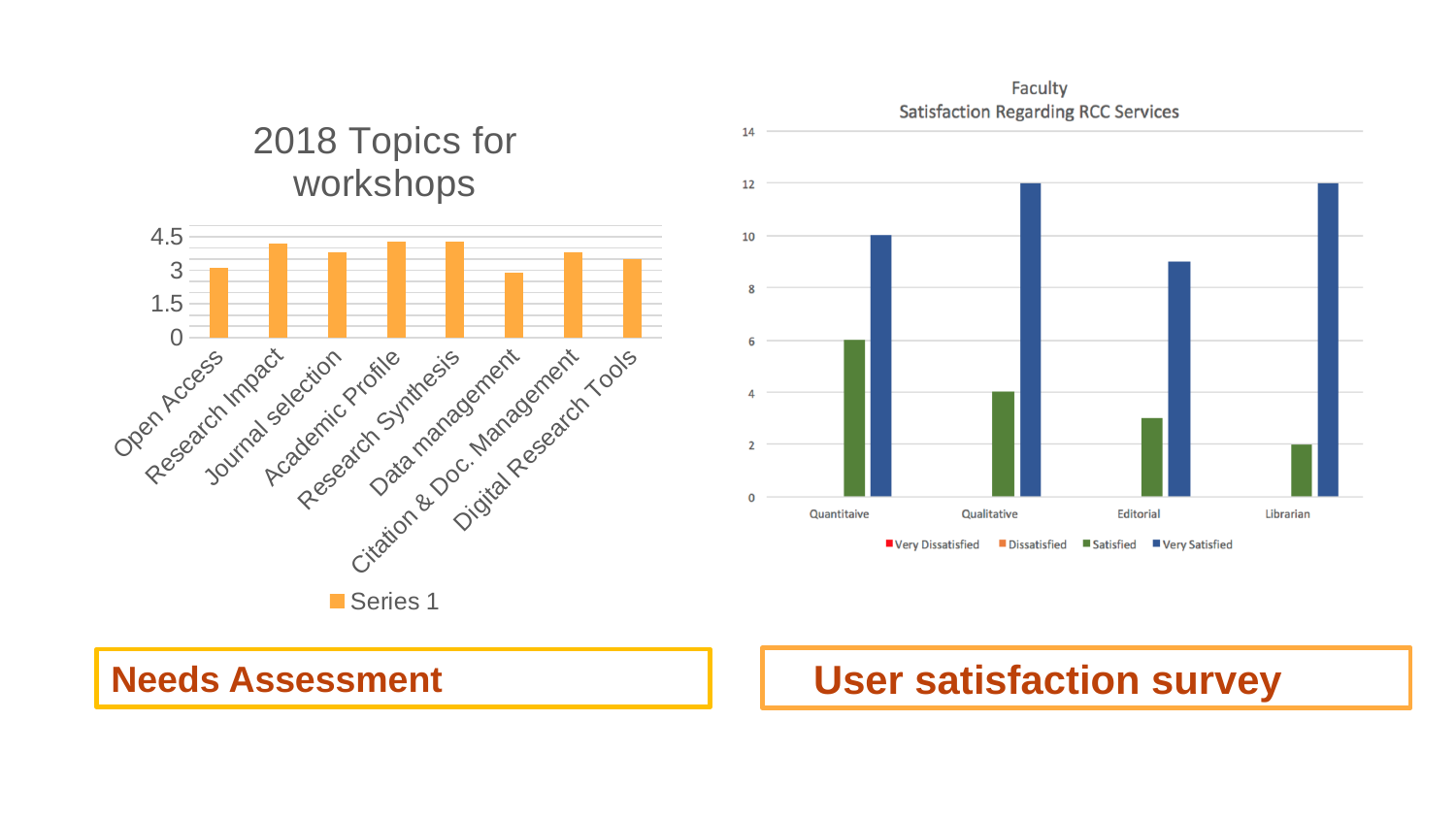
On the 'Faculty Satisfaction Regarding RCC Services' chart, what is the Very Satisfied value for Librarian? 12 On the '2018 Topics for workshops' chart, what kind of chart is used? Bar chart On the 'Faculty Satisfaction Regarding RCC Services' chart, what is the Satisfied value for Qualitative? 4 On the 'Faculty Satisfaction Regarding RCC Services' chart, how many series does the legend list? 4 On the 'Faculty Satisfaction Regarding RCC Services' chart, what is the difference between the Very Satisfied and Satisfied values for Quantitaive? 4 On the 'Faculty Satisfaction Regarding RCC Services' chart, is the Very Satisfied value for Editorial greater or less than 8? greater On the 'Faculty Satisfaction Regarding RCC Services' chart, what is the Very Satisfied value for Quantitaive? 10 On the '2018 Topics for workshops' chart, how many workshop topics are shown on the x axis? 8 On the '2018 Topics for workshops' chart, what is the only entry in the legend? Series 1 On the '2018 Topics for workshops' chart, is the value for Research Impact greater or less than 3? greater On the 'Faculty Satisfaction Regarding RCC Services' chart, which category has the lowest Satisfied value? Librarian